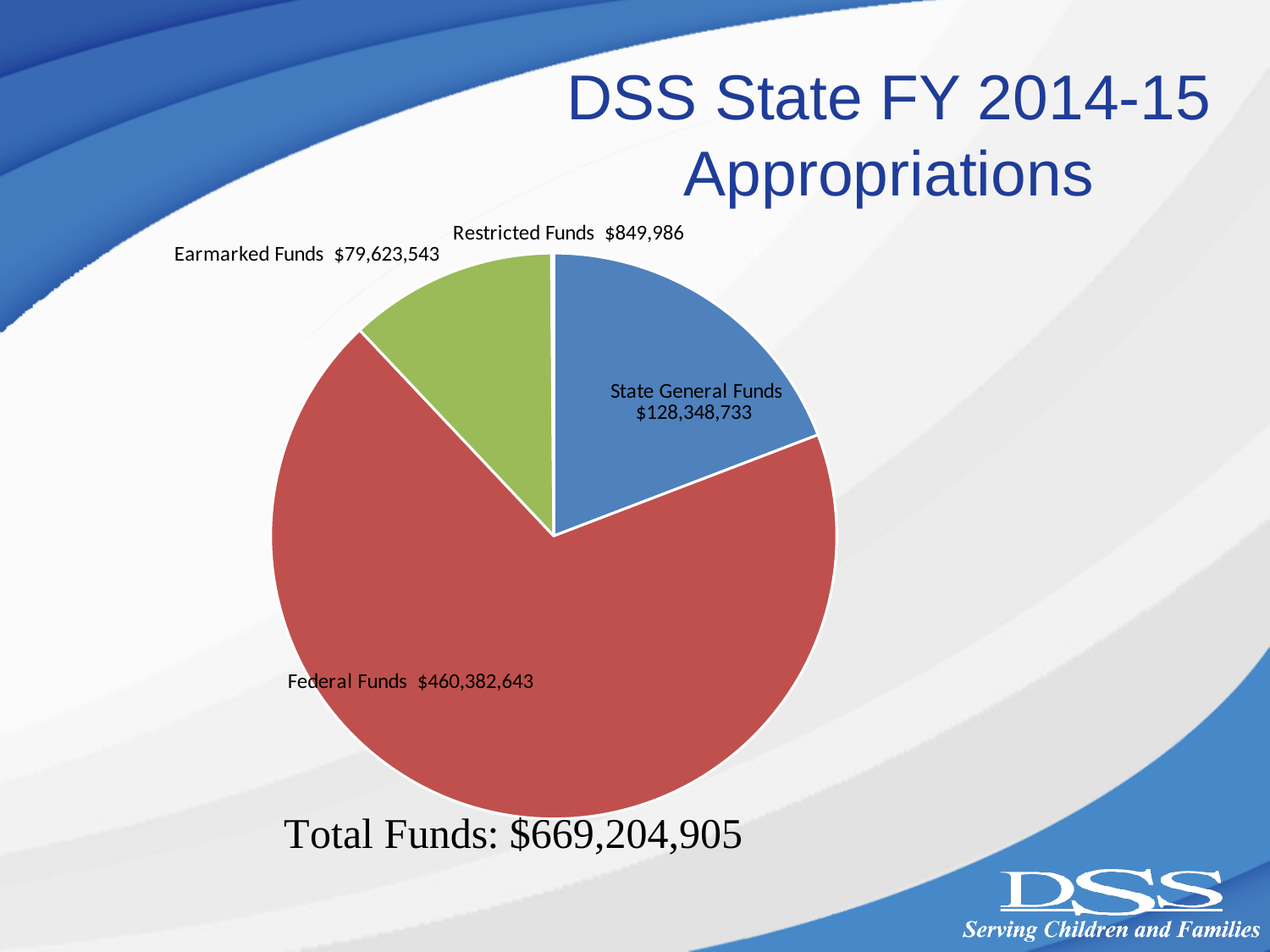
Which fund category has the largest slice of the pie? Federal Funds What is the value for Restricted Funds? $849,986 What is the value for Earmarked Funds? $79,623,543 Which fund category has the smallest slice of the pie? Restricted Funds What kind of chart is shown on the slide? Pie chart What is the value for Federal Funds? $460,382,643 What is the title of the slide containing the chart? DSS State FY 2014-15 Appropriations Which is larger, State General Funds or Earmarked Funds? State General Funds What is the value for State General Funds? $128,348,733 What is the difference between Federal Funds and State General Funds? $332,033,910 How many slices does the pie chart have? 4 What is the total of all funds shown on the slide? $669,204,905